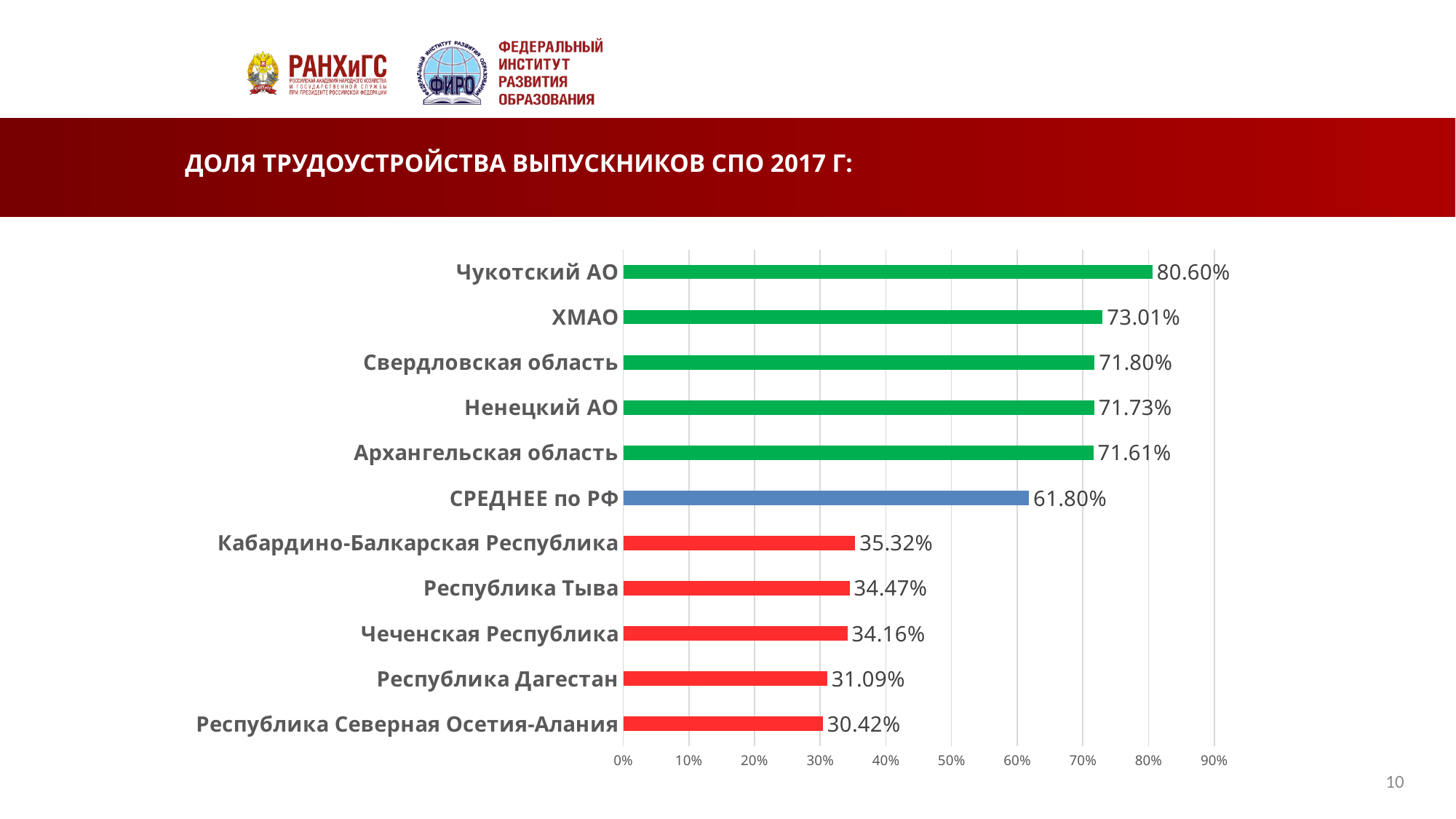
What is the value for СРЕДНЕЕ по РФ? 61.80% Which is larger, the value for Свердловская область or the value for Кабардино-Балкарская Республика? Свердловская область What is the value for Республика Тыва? 34.47% What is the difference between the values for СРЕДНЕЕ по РФ and Республика Дагестан? 30.71% What is the difference between the values for Чукотский АО and ХМАО? 7.59% Is the value for Чеченская Республика greater or less than 40%? less Which category has the highest value? Чукотский АО How many categories are shown in the chart? 11 What is the value for Чукотский АО? 80.60% What colour is the bar for СРЕДНЕЕ по РФ? blue What kind of chart is shown on the slide? bar chart Which category has the lowest value? Республика Северная Осетия-Алания